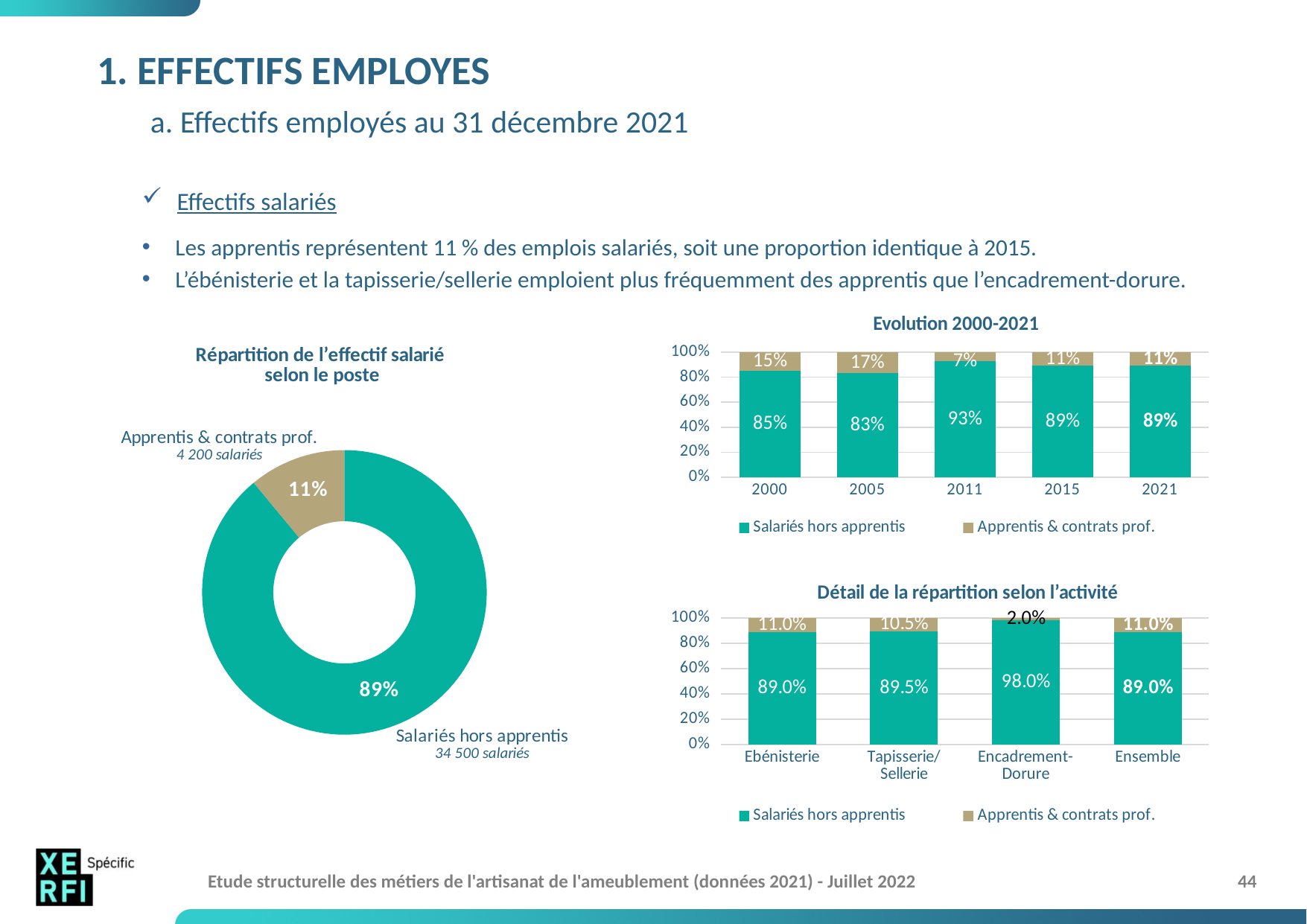
In the 'Evolution 2000-2021' chart, which year has the lowest share of 'Apprentis & contrats prof.'? 2011 What kind of chart is 'Répartition de l'effectif salarié selon le poste'? Donut (pie) chart In the 'Détail de la répartition selon l'activité' chart, which activity has the highest share of 'Apprentis & contrats prof.'? Ebénisterie In the 'Répartition de l'effectif salarié selon le poste' chart, what share of the donut is 'Apprentis & contrats prof.'? 11% In the 'Evolution 2000-2021' chart, how many years are shown on the x axis? 5 In the 'Détail de la répartition selon l'activité' chart, what is the value for 'Salariés hors apprentis' for Encadrement-Dorure? 98.0% In the 'Evolution 2000-2021' chart, what is the difference between the 'Apprentis & contrats prof.' share in 2005 and in 2021? 6 percentage points How many series does the legend of the 'Détail de la répartition selon l'activité' chart list? 2 In the 'Détail de la répartition selon l'activité' chart, is the 'Apprentis & contrats prof.' share larger for Tapisserie/Sellerie or for Encadrement-Dorure? Tapisserie/Sellerie In the 'Evolution 2000-2021' chart, what is the value for 'Apprentis & contrats prof.' in 2005? 17% In the 'Répartition de l'effectif salarié selon le poste' chart, how many salariés are labelled for 'Salariés hors apprentis'? 34 500 salariés In the 'Evolution 2000-2021' chart, what is the value for 'Salariés hors apprentis' in 2011? 93%